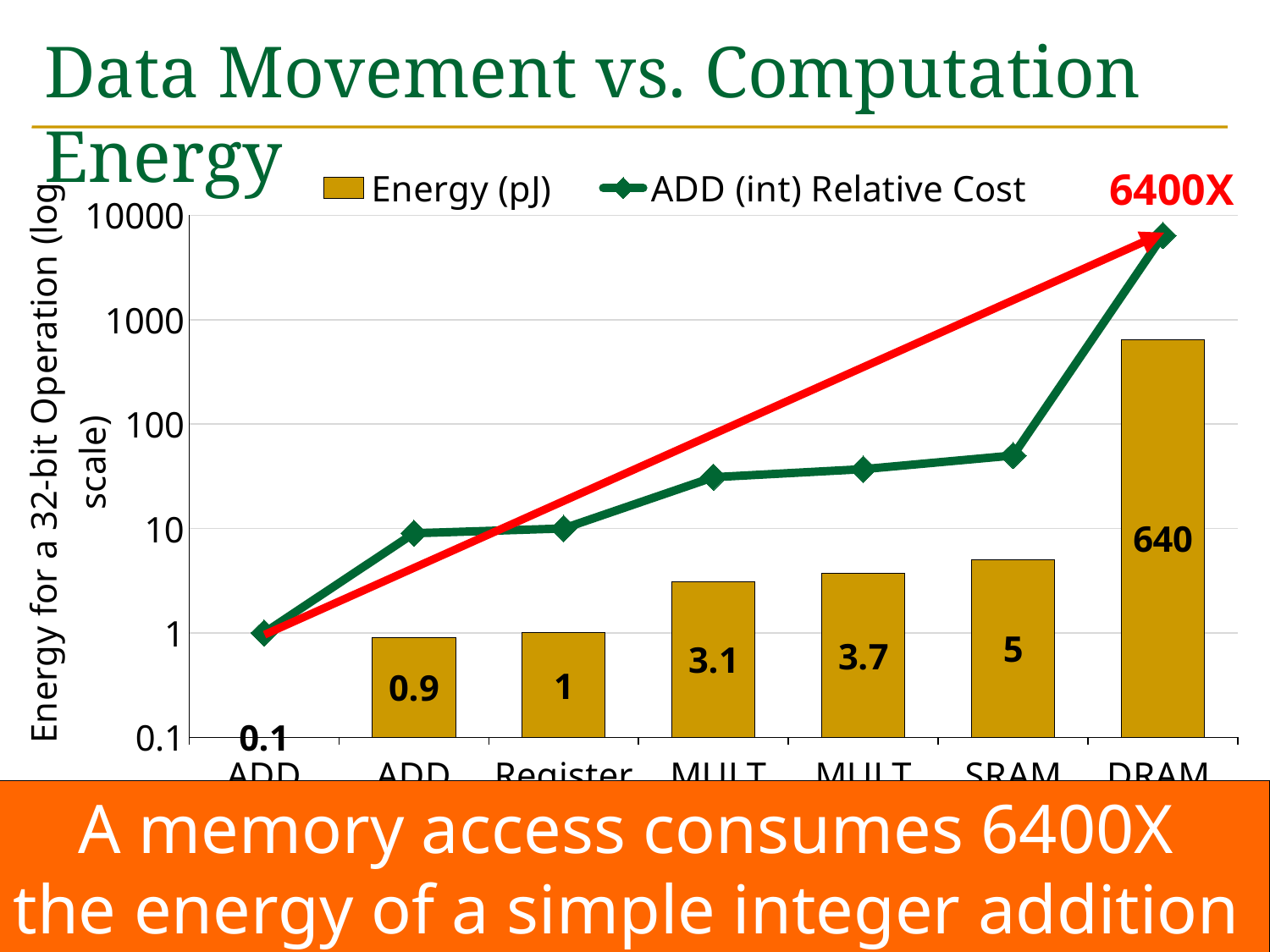
What kind of chart is this? Combined bar and line chart How many series does the legend list? 2 What is the Energy (pJ) value shown for Register? 1 Which category has the highest Energy (pJ) bar? DRAM Is the ADD (int) Relative Cost value at SRAM greater or less than 10? greater What is the Energy (pJ) value shown for SRAM? 5 What is the Energy (pJ) value shown for DRAM? 640 Which category has the lowest Energy (pJ) value? ADD (the first category, 0.1) How many categories are shown on the x axis? 7 Is the ADD (int) Relative Cost value at DRAM greater or less than 1000? greater Which has a larger Energy (pJ) value, SRAM or Register? SRAM What is the difference between the Energy (pJ) values for DRAM and SRAM? 635